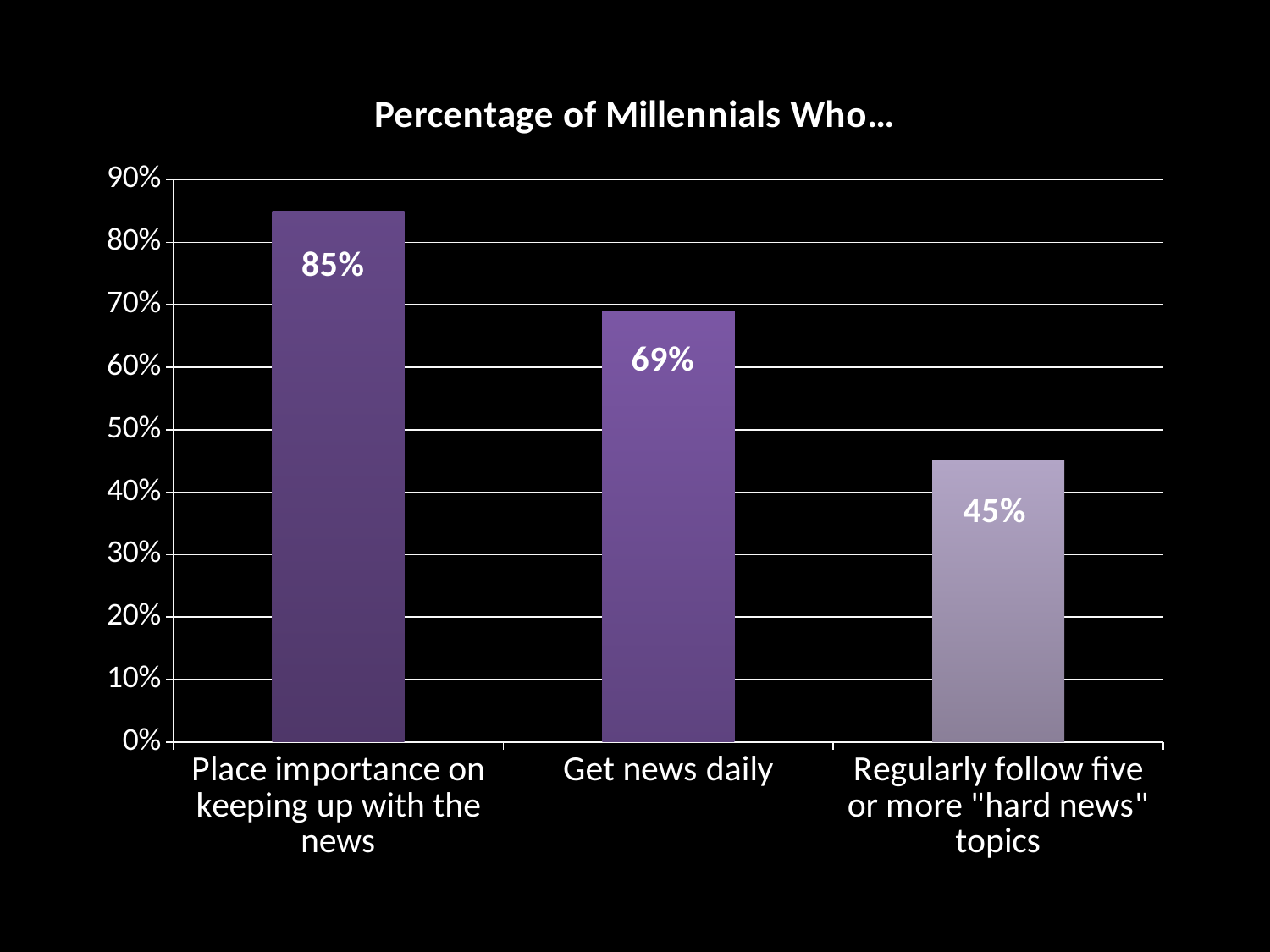
What kind of chart is shown on the slide? Bar chart Is the value for "Get news daily" greater or less than 60%? greater What percentage of Millennials regularly follow five or more "hard news" topics? 45% What is the title of the chart? Percentage of Millennials Who... Which category has the lowest percentage? Regularly follow five or more "hard news" topics How many categories are shown in the chart? 3 What is the difference in percentage points between those who place importance on keeping up with the news and those who get news daily? 16 What percentage of Millennials place importance on keeping up with the news? 85% Which category has the highest percentage? Place importance on keeping up with the news Which is larger: the percentage who get news daily or the percentage who regularly follow five or more "hard news" topics? Get news daily What percentage of Millennials get news daily? 69% What is the difference in percentage points between those who get news daily and those who regularly follow five or more "hard news" topics? 24